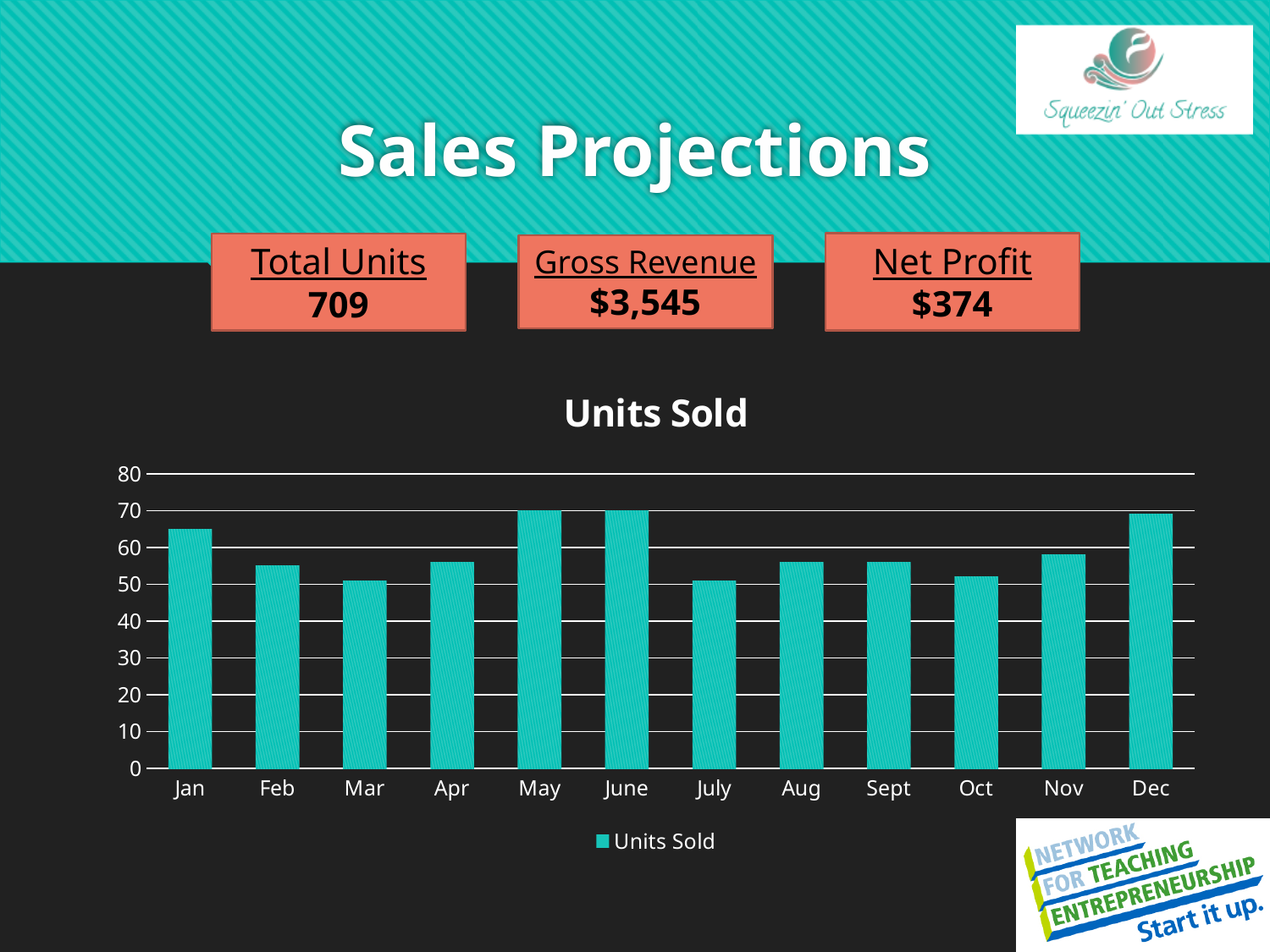
Which month has the larger value, Jan or Feb? Jan What is the title of the chart? Units Sold Is the value for Oct greater or less than 60? less Is the value for Dec greater or less than 60? greater How many series does the chart legend list? 1 How many months are shown on the x axis of the chart? 12 Is the value for Jan greater or less than 60? greater Which month has the larger value, June or July? June What is the value for May in the Units Sold chart? 70 What kind of chart is shown on the slide? bar chart Do the values rise or fall from Jan to Mar? fall